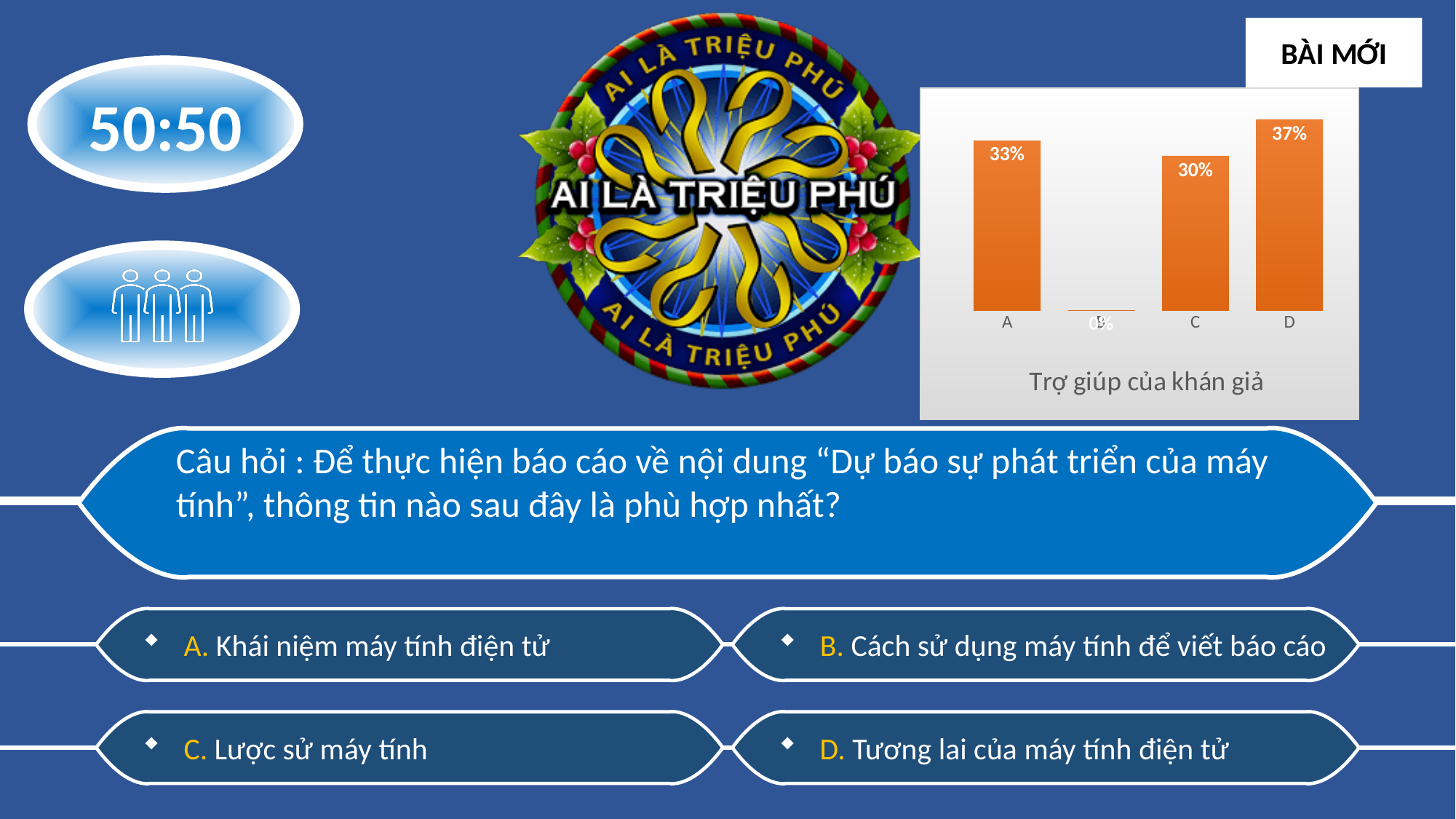
What kind of chart is shown on the slide? bar chart Which category has the highest value in the chart? D What colour are the bars in the chart? orange What is the difference between the values for A and C? 3% Which is larger, the value for A or the value for C? A What is the value for category C in the chart? 30% What is the title of the chart? Trợ giúp của khán giả What is the difference between the values for D and C? 7% Which is larger, the value for D or the value for A? D What is the value for category A in the chart? 33% How many categories are shown on the x axis of the chart? 4 What is the value for category D in the chart? 37%